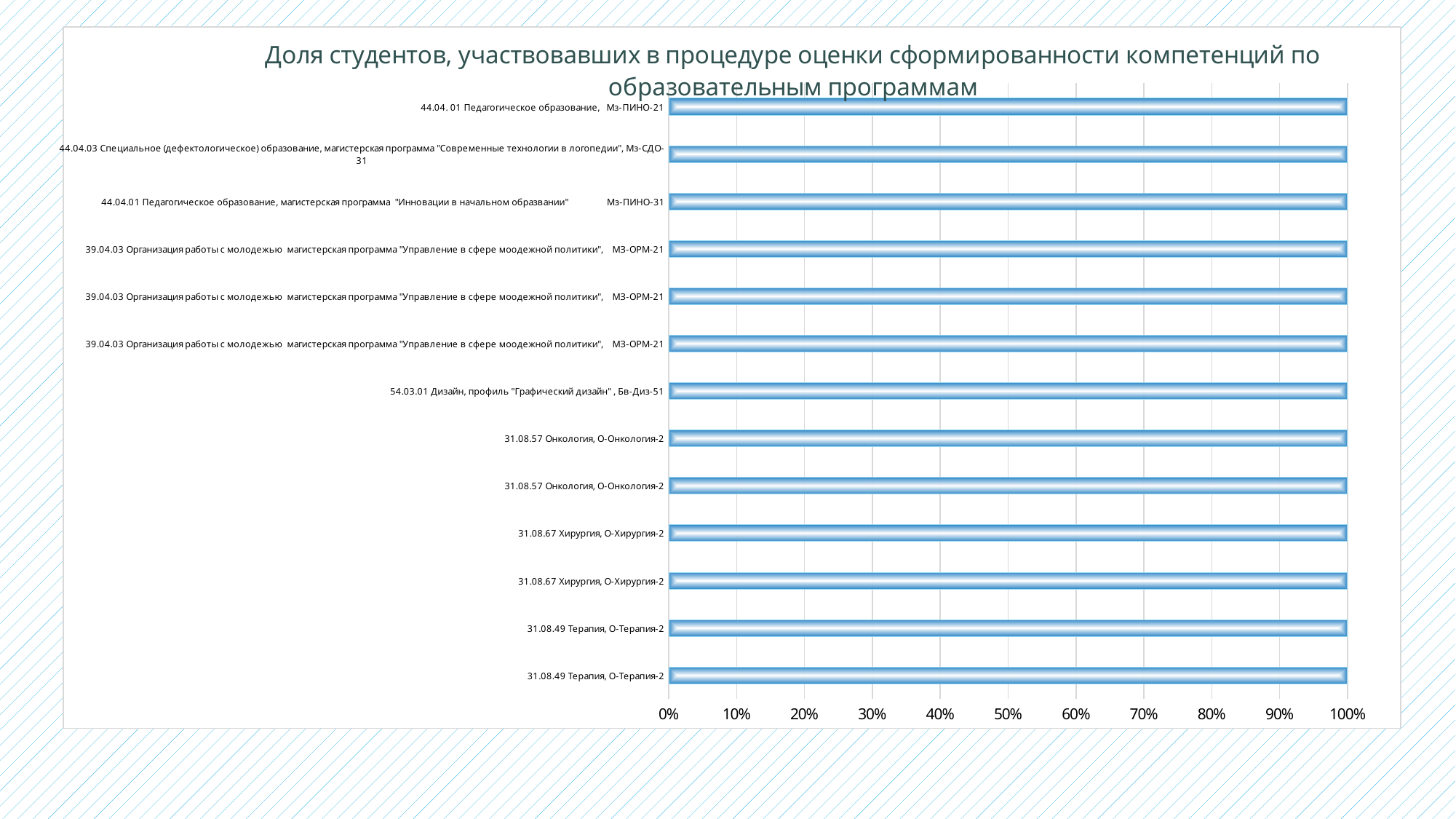
Is the value for 31.08.57 Онкология, О-Онкология-2 greater or less than 90%? greater How many categories (bars) does the chart show? 13 What is the value for 44.04.03 Специальное (дефектологическое) образование, магистерская программа "Современные технологии в логопедии", Мз-СДО-31? 100% What is the difference between the value for 31.08.57 Онкология, О-Онкология-2 and the value for 54.03.01 Дизайн, профиль "Графический дизайн", Бв-Диз-51? 0% What is the title of the chart? Доля студентов, участвовавших в процедуре оценки сформированности компетенций по образовательным программам What is the value for 44.04. 01 Педагогическое образование, Мз-ПИНО-21? 100% What is the value for 31.08.49 Терапия, О-Терапия-2? 100% Is the value for 31.08.67 Хирургия, О-Хирургия-2 greater or less than 50%? greater What is the highest value shown on the horizontal axis? 100% What kind of chart is shown on the slide? bar chart What is the value for 54.03.01 Дизайн, профиль "Графический дизайн", Бв-Диз-51? 100%